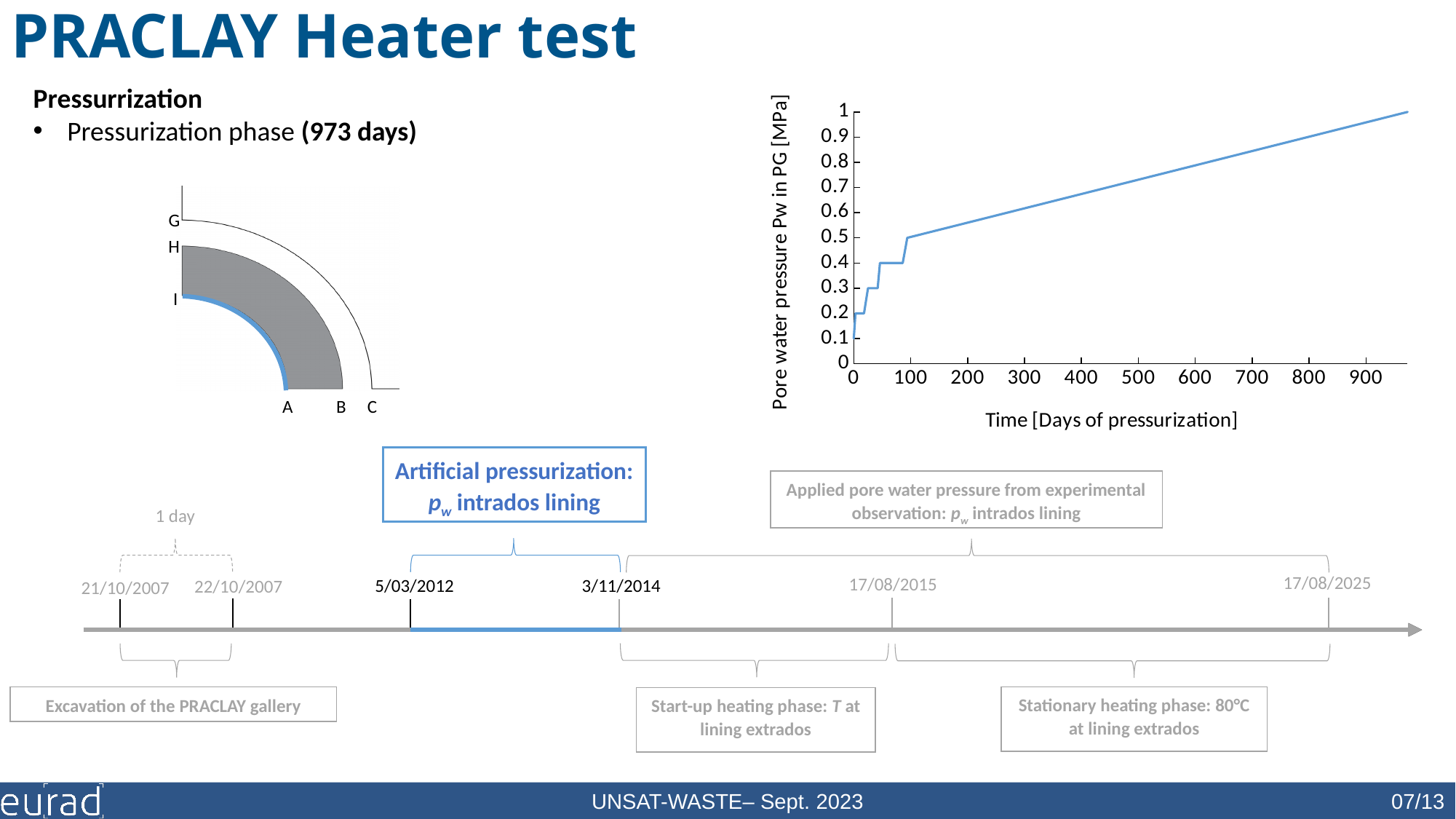
What is the highest value on the y axis of the chart? 1 Is the pore water pressure at 300 days greater or less than 0.5? greater What pore water pressure does the line reach at the end of the pressurization period? 1 What kind of chart is shown on the right of the slide? line chart Is the pore water pressure at 500 days greater or less than 0.6? greater Is the pore water pressure higher at 800 days or at 200 days? 800 days Is the pore water pressure at 50 days greater or less than 0.5? less What is the label of the y axis of the chart? Pore water pressure Pw in PG [MPa] What is the label of the x axis of the chart? Time [Days of pressurization] Does the pore water pressure rise or fall as time increases along the x axis? rise